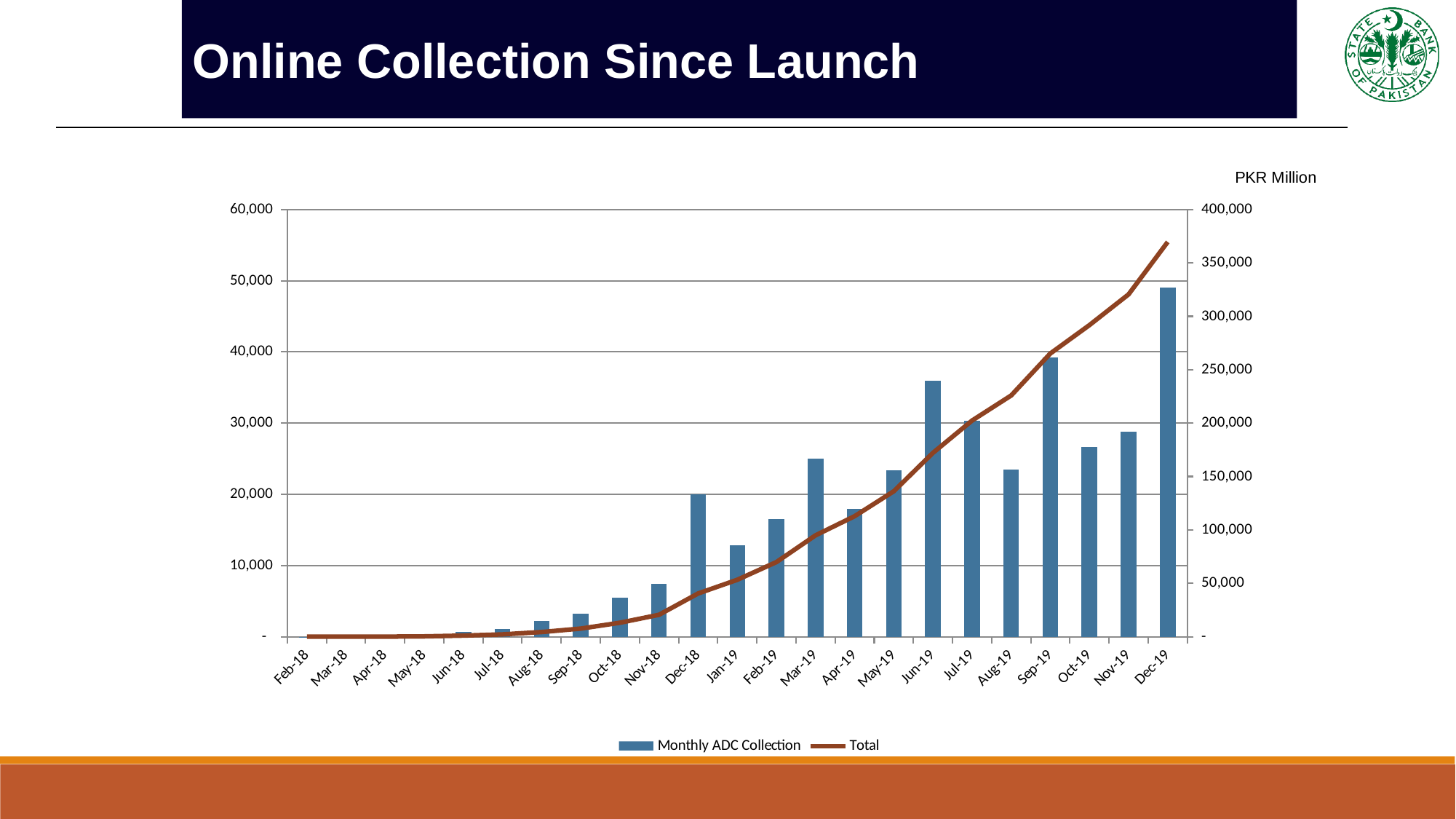
How many months are shown on the x axis? 23 Which month has the highest Monthly ADC Collection bar? Dec-19 What kind of chart is shown on the slide? A combination bar and line chart Which month has the larger Monthly ADC Collection, Jun-19 or Jul-19? Jun-19 Is the Monthly ADC Collection for Jun-19 greater or less than 30,000? greater How many series does the legend list? 2 Is the Total value for Dec-19 greater or less than 350,000 on the right axis? greater Is the Monthly ADC Collection for Nov-18 greater or less than 10,000? less Which month has the larger Monthly ADC Collection, Sep-19 or Oct-19? Sep-19 What unit is indicated above the right-hand axis of the chart? PKR Million Does the Total line rise or fall from Feb-18 to Dec-19? Rises